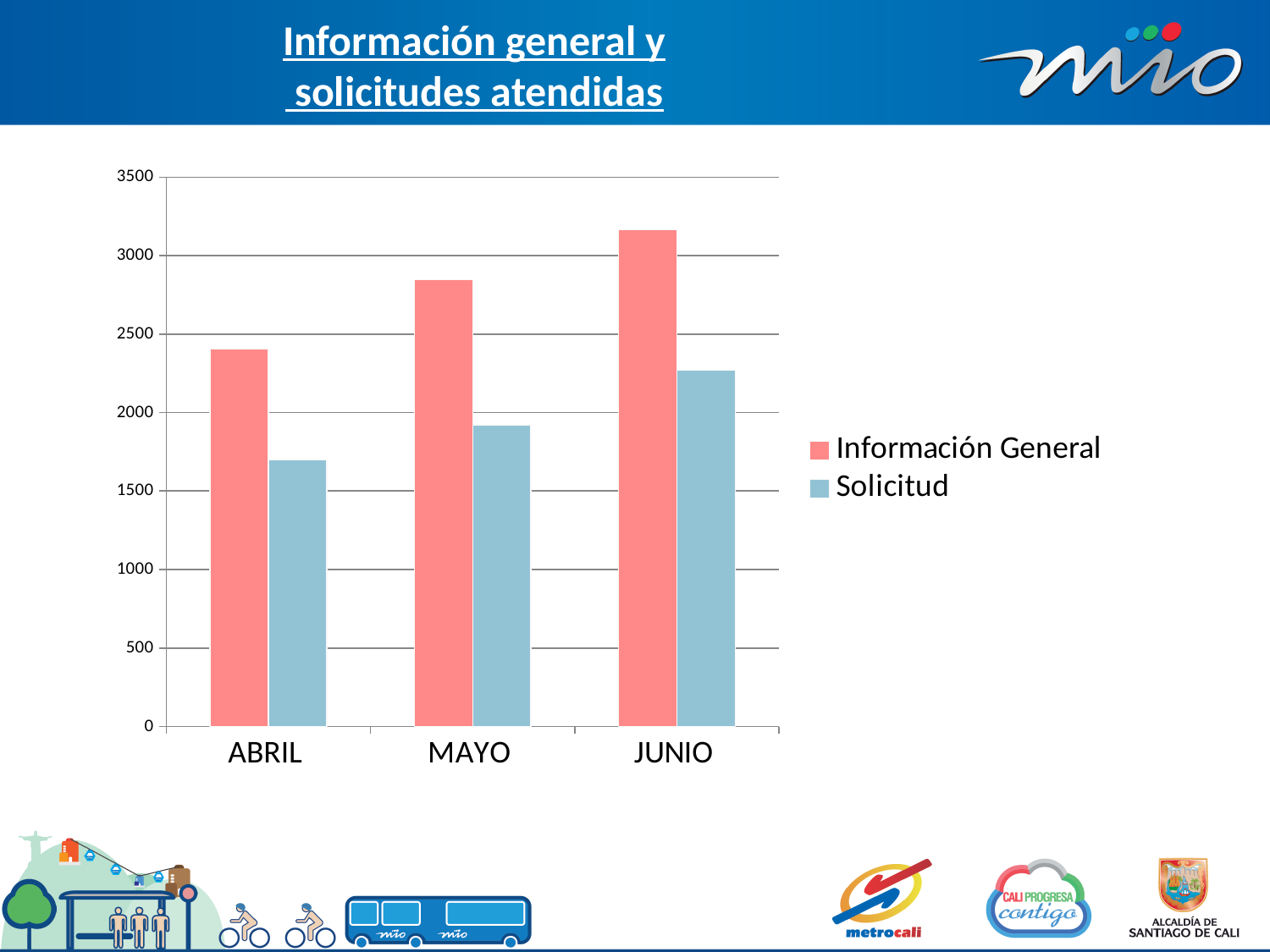
In MAYO, which is larger: Información General or Solicitud? Información General Is the value for Información General in MAYO greater or less than 2500? greater Is the value for Solicitud in ABRIL greater or less than 2000? less What kind of chart is shown on the slide? bar chart Is the value for Solicitud in JUNIO greater or less than 2000? greater Do the Solicitud values rise or fall from ABRIL to JUNIO? rise How many months are shown on the x axis? 3 Which month has the lowest value for Solicitud? ABRIL How many series does the legend list? 2 Which month has the highest value for Información General? JUNIO What colour are the Solicitud bars? light blue